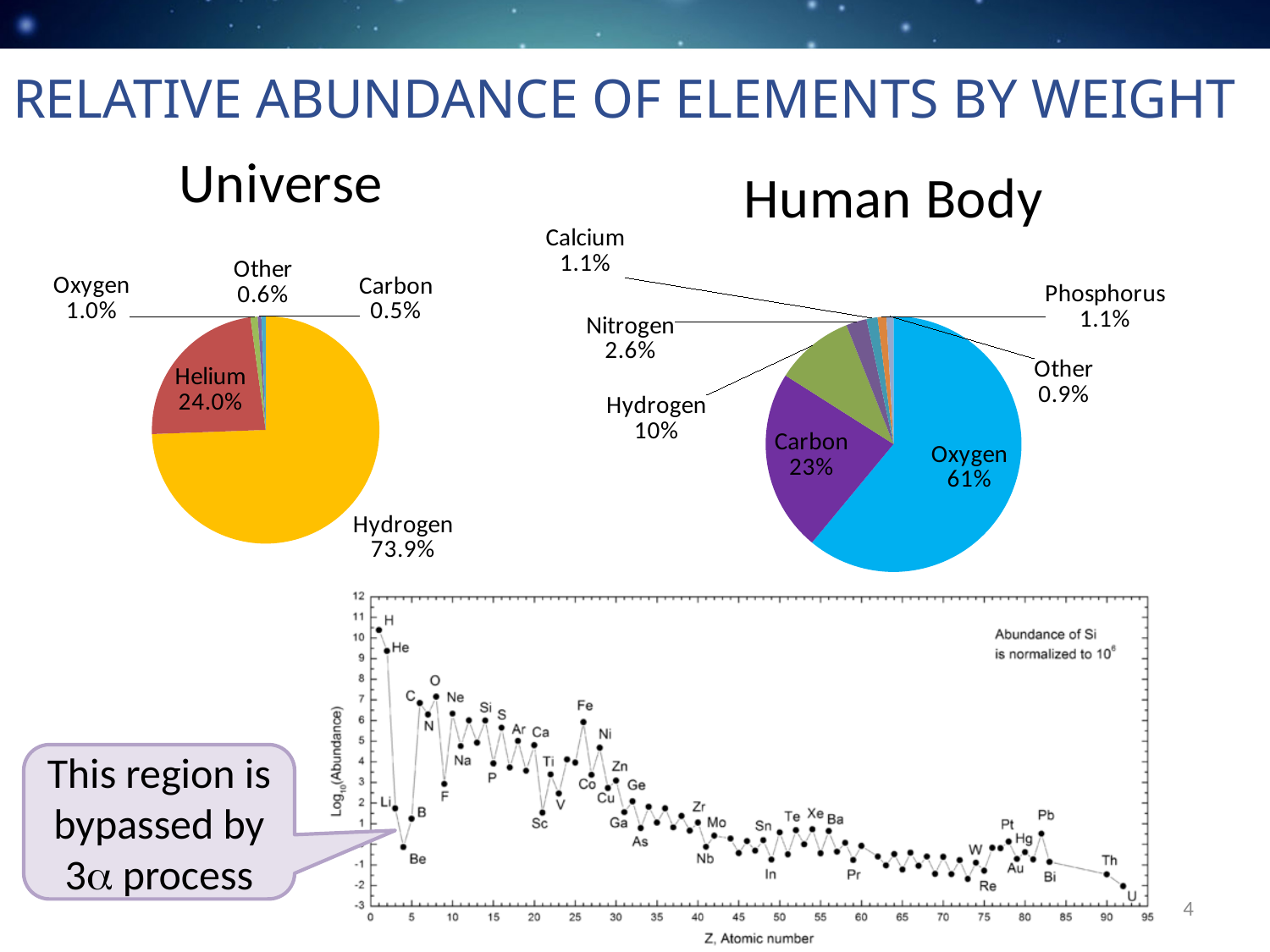
In the Universe pie chart, how many slices are there? 5 In the Human Body pie chart, what is the share for Oxygen? 61% In the Human Body pie chart, how many slices are there? 7 In the Universe pie chart, what is the difference between the Hydrogen and Helium shares? 49.9% In the Universe pie chart, what is the share for Helium? 24.0% What is the x-axis label of the bottom chart? Z, Atomic number In the Human Body pie chart, which is larger, the share for Carbon or the share for Hydrogen? Carbon In the Universe pie chart, what is the share for Hydrogen? 73.9% In the Human Body pie chart, which element has the largest share? Oxygen In the Universe pie chart, which element has the smallest share? Carbon In the Human Body pie chart, what is the share for Nitrogen? 2.6% In the bottom chart of abundance versus atomic number, is the Log10(Abundance) value for H greater or less than 10? greater